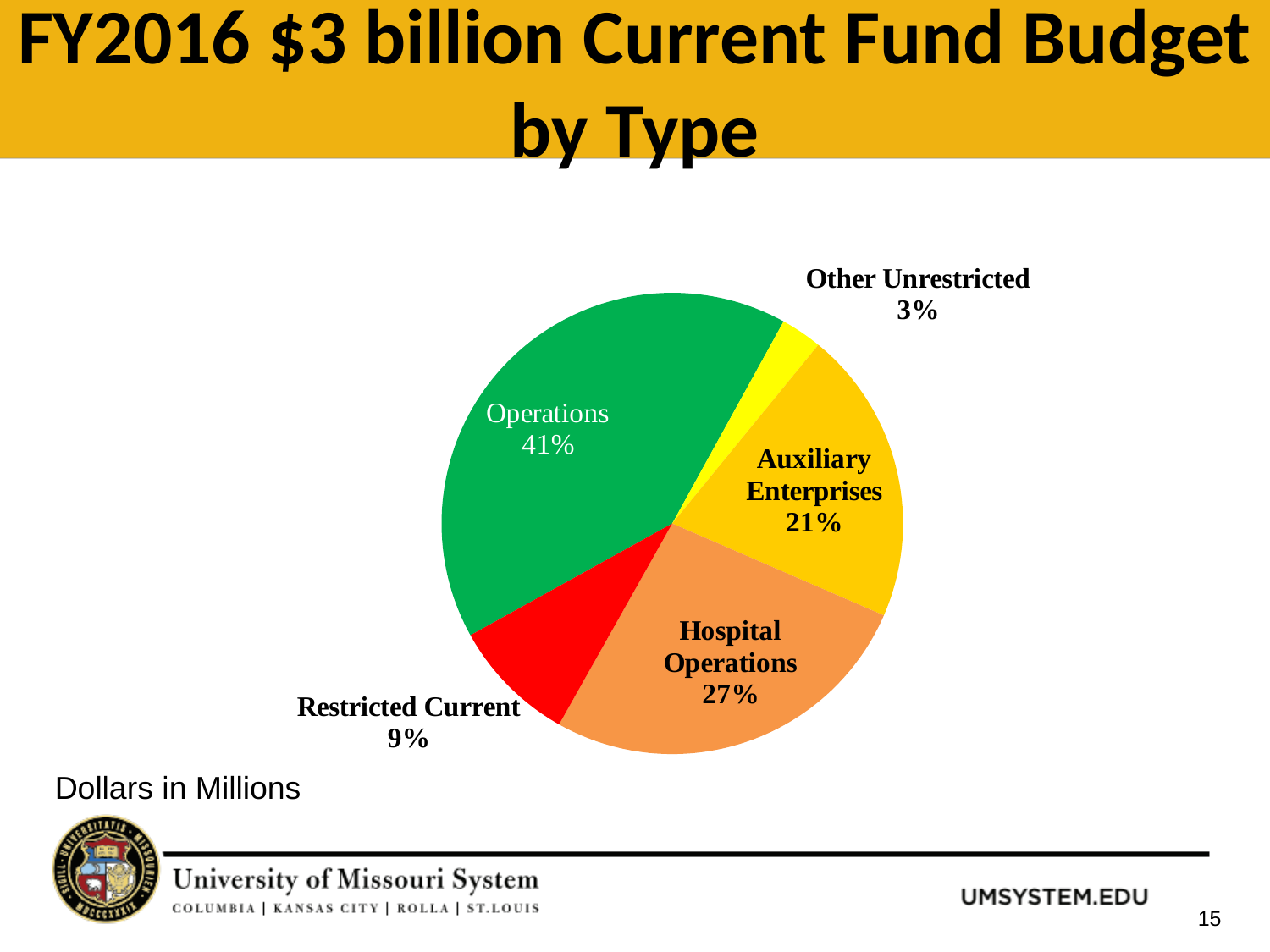
How many categories are shown in the pie chart? 5 What share of the budget is Auxiliary Enterprises? 21% Which is larger, Auxiliary Enterprises or Restricted Current? Auxiliary Enterprises What share of the FY2016 Current Fund Budget is Operations? 41% What is the title of the slide containing the pie chart? FY2016 $3 billion Current Fund Budget by Type Which category has the largest share of the budget? Operations What share of the budget is Other Unrestricted? 3% What share of the budget is Hospital Operations? 27% Which category has the smallest share of the budget? Other Unrestricted What share of the budget is Restricted Current? 9% What kind of chart is shown on the slide? pie chart What is the difference in percentage points between Operations and Hospital Operations? 14